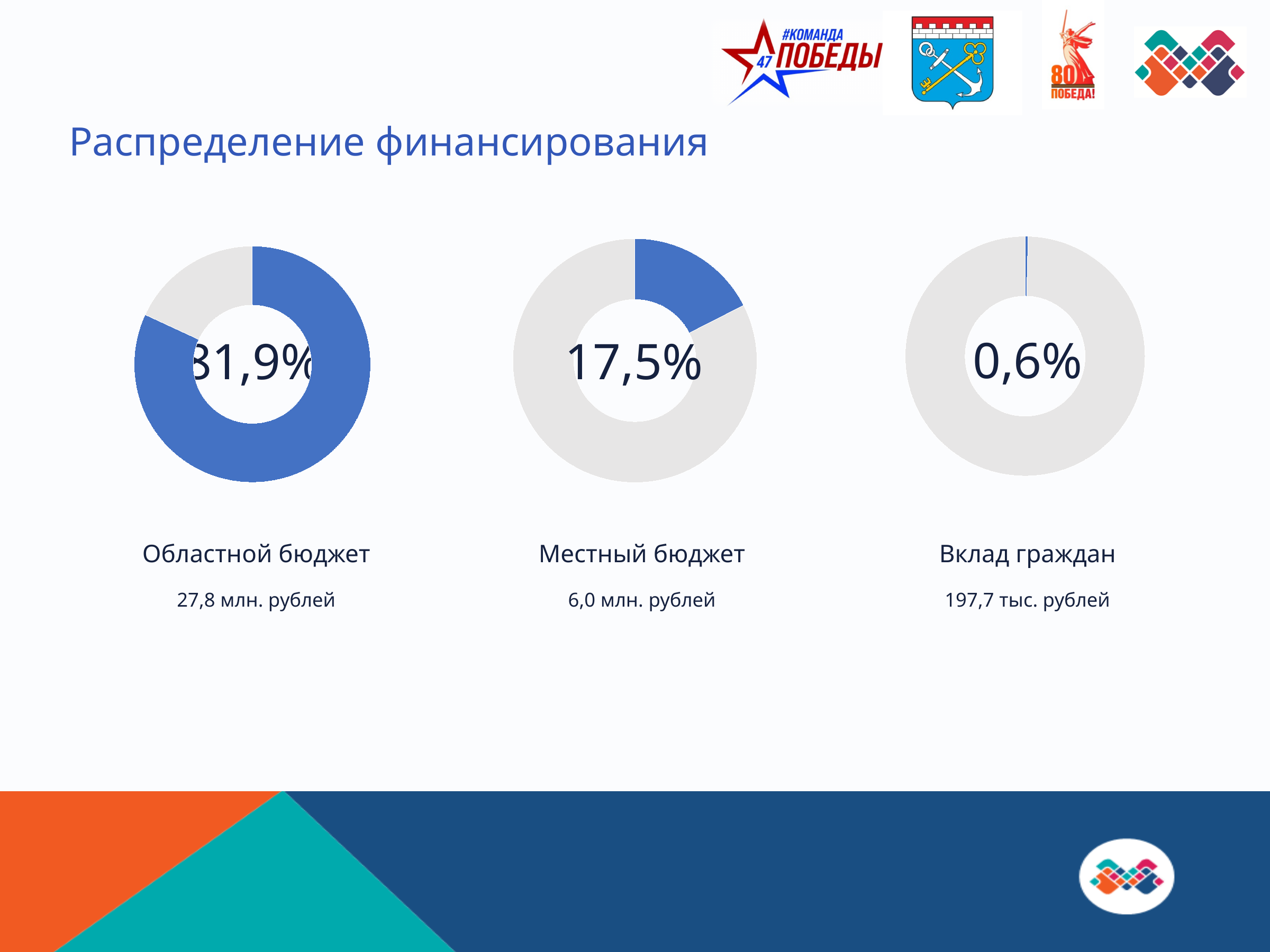
What kind of chart is used for each of the three charts on the slide? Donut (pie) chart What amount in rubles is given under the chart labelled Областной бюджет? 27,8 млн. рублей How many donut charts are shown on the slide? 3 In the chart labelled Вклад граждан, what percentage is shown in the centre? 0,6% Which of the three funding sources has the largest share? Областной бюджет What is the title of the slide containing the three donut charts? Распределение финансирования What amount in rubles is given under the chart labelled Местный бюджет? 6,0 млн. рублей In the chart labelled Местный бюджет, what percentage is shown in the centre? 17,5% Which share is larger: Местный бюджет or Вклад граждан? Местный бюджет Which of the three funding sources has the smallest share? Вклад граждан What amount in rubles is given under the chart labelled Вклад граждан? 197,7 тыс. рублей What is the difference in percentage points between the Местный бюджет share (17,5%) and the Вклад граждан share (0,6%)? 16,9